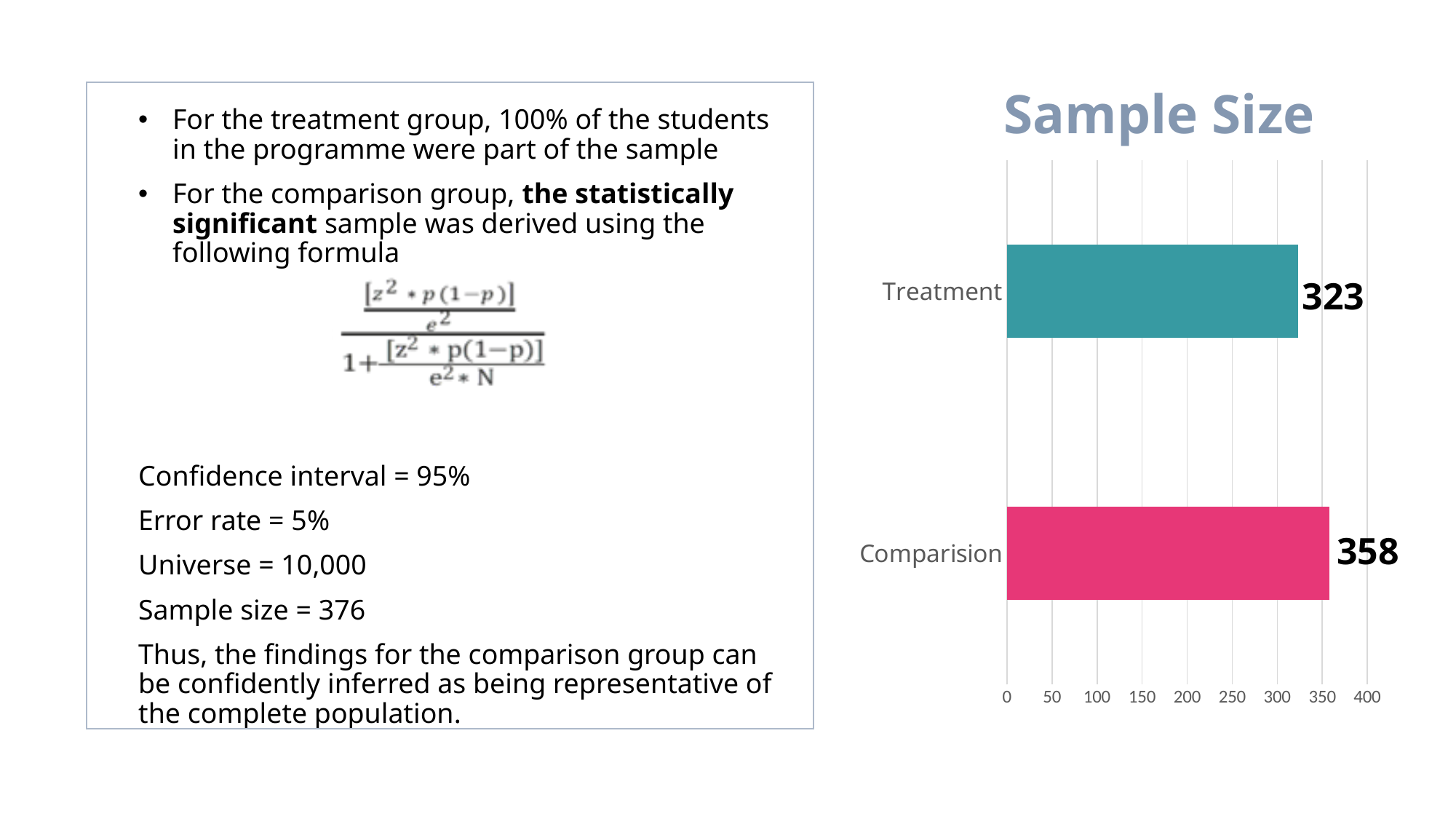
Which group has the larger sample size? Comparision Is the value for Treatment greater or less than 300? greater What is the title of the chart? Sample Size What is the difference between the Comparision and Treatment sample sizes? 35 How many groups are shown in the chart? 2 Is the Treatment sample size larger or smaller than the Comparision sample size? smaller Is the value for Comparision greater or less than 400? less What is the sample size for the Comparision group? 358 What is the sample size for the Treatment group? 323 Which group has the smaller sample size? Treatment What kind of chart is shown on the slide? bar chart What is the highest value shown on the chart's axis? 400